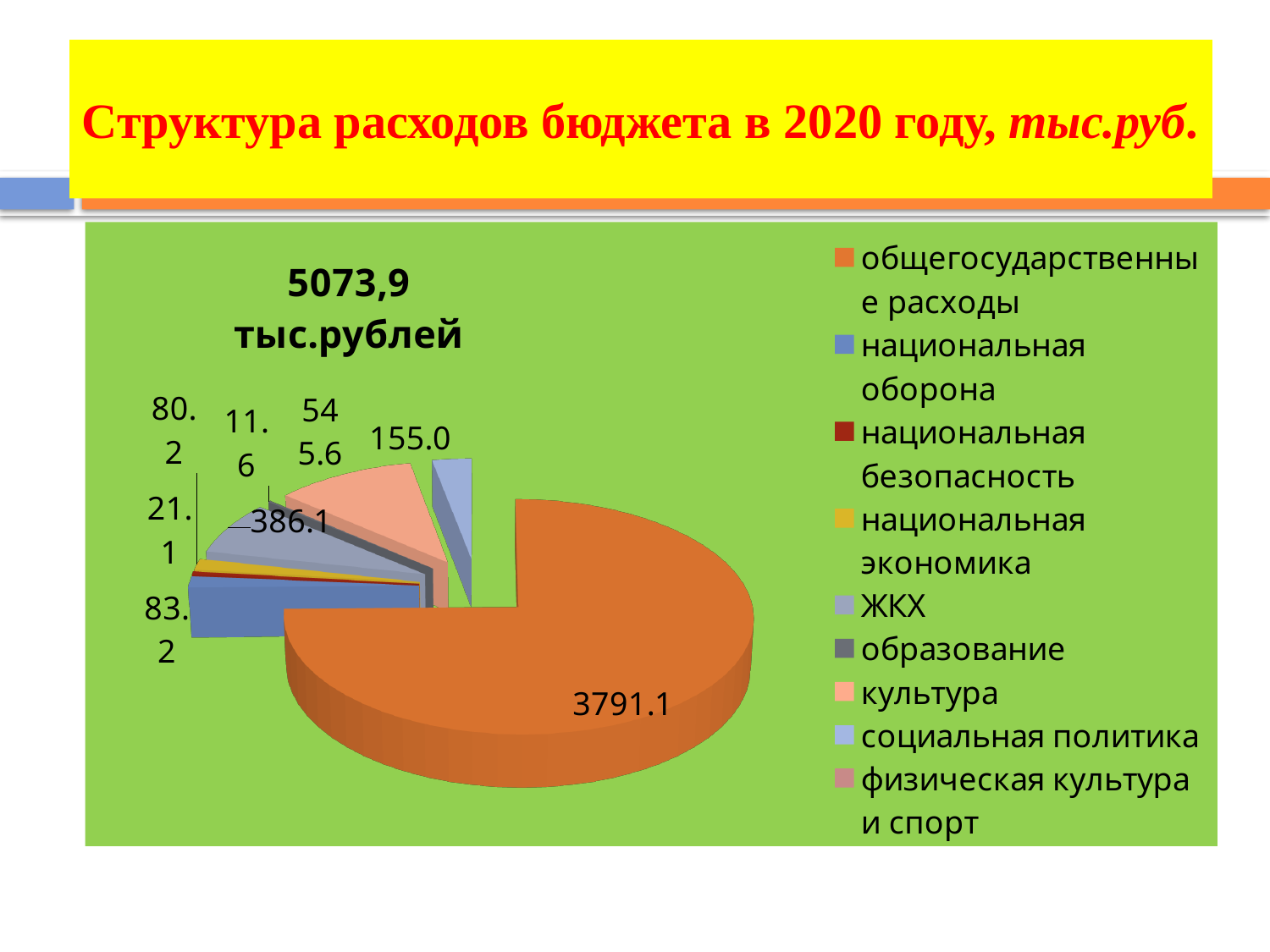
What kind of chart is shown on the slide? pie chart What is the smallest value printed on the pie chart? 11.6 What share of the total 5073,9 does the largest slice (3791.1) represent? 74.7% Which category has the largest slice of the pie? общегосударственные расходы Which is larger, the slice for общегосударственные расходы or the slice for национальная оборона? общегосударственные расходы What is the value of the largest slice (общегосударственные расходы)? 3791.1 What colour is the largest slice of the pie? orange How many categories does the legend list? 9 What is the title shown above the pie chart? 5073,9 тыс.рублей What is the total of the budget expenditures shown in the chart title? 5073,9 тыс.рублей What is the value labelled on the национальная оборона slice? 83.2